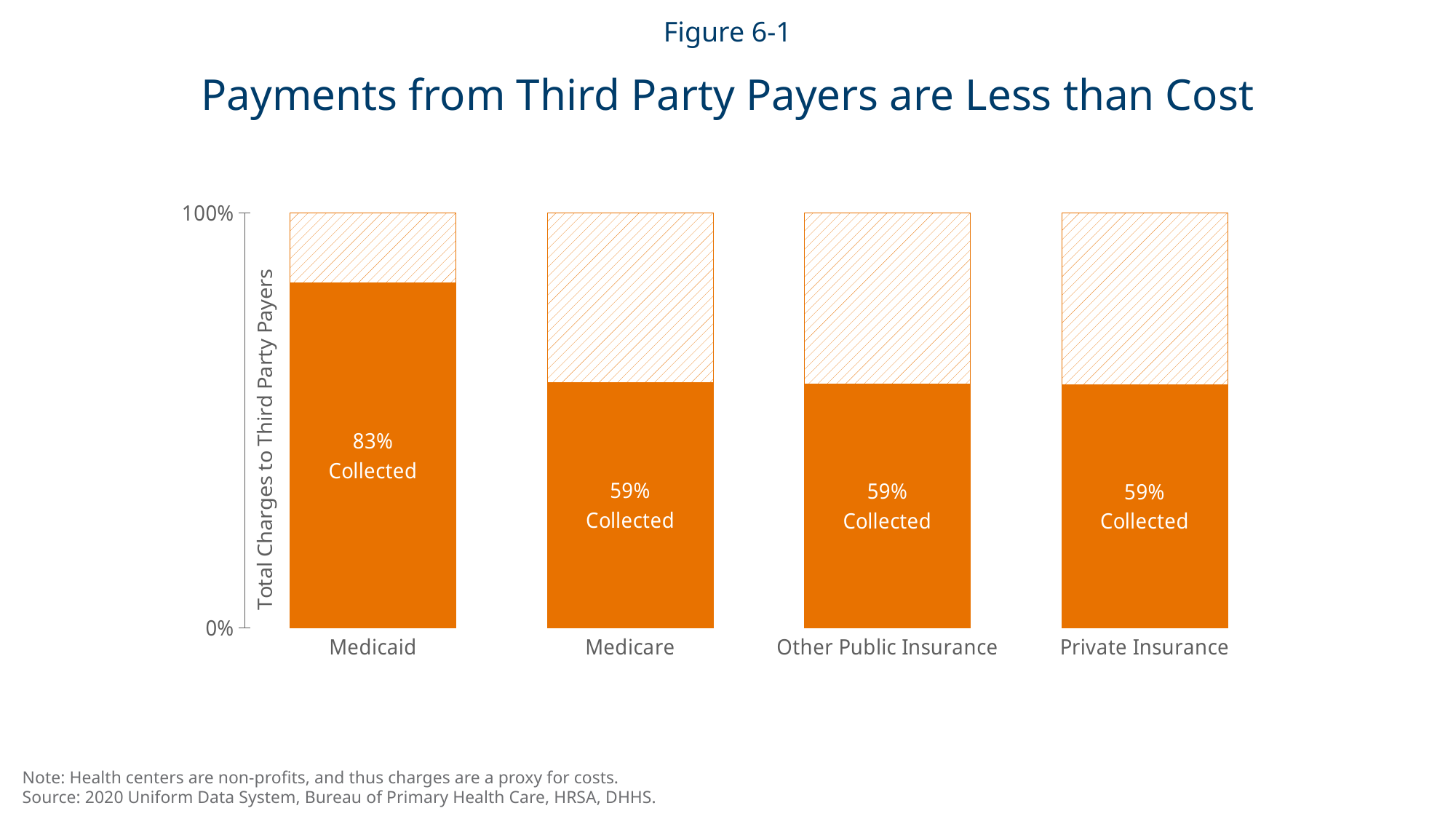
Which payer has the highest percentage of charges collected? Medicaid What is the difference in percentage collected between Medicaid and Medicare? 24% What is the title of the chart? Payments from Third Party Payers are Less than Cost How many payer categories have 59% of charges collected? 3 How many payer categories are shown on the chart? 4 What is the label on the vertical axis? Total Charges to Third Party Payers What percentage of charges is collected for Private Insurance? 59% Which has a higher percentage collected, Medicaid or Private Insurance? Medicaid What percentage of charges is collected for Medicare? 59% What percentage of charges is collected for Other Public Insurance? 59% What type of chart is shown on the slide? Bar chart What percentage of charges is collected for Medicaid? 83%